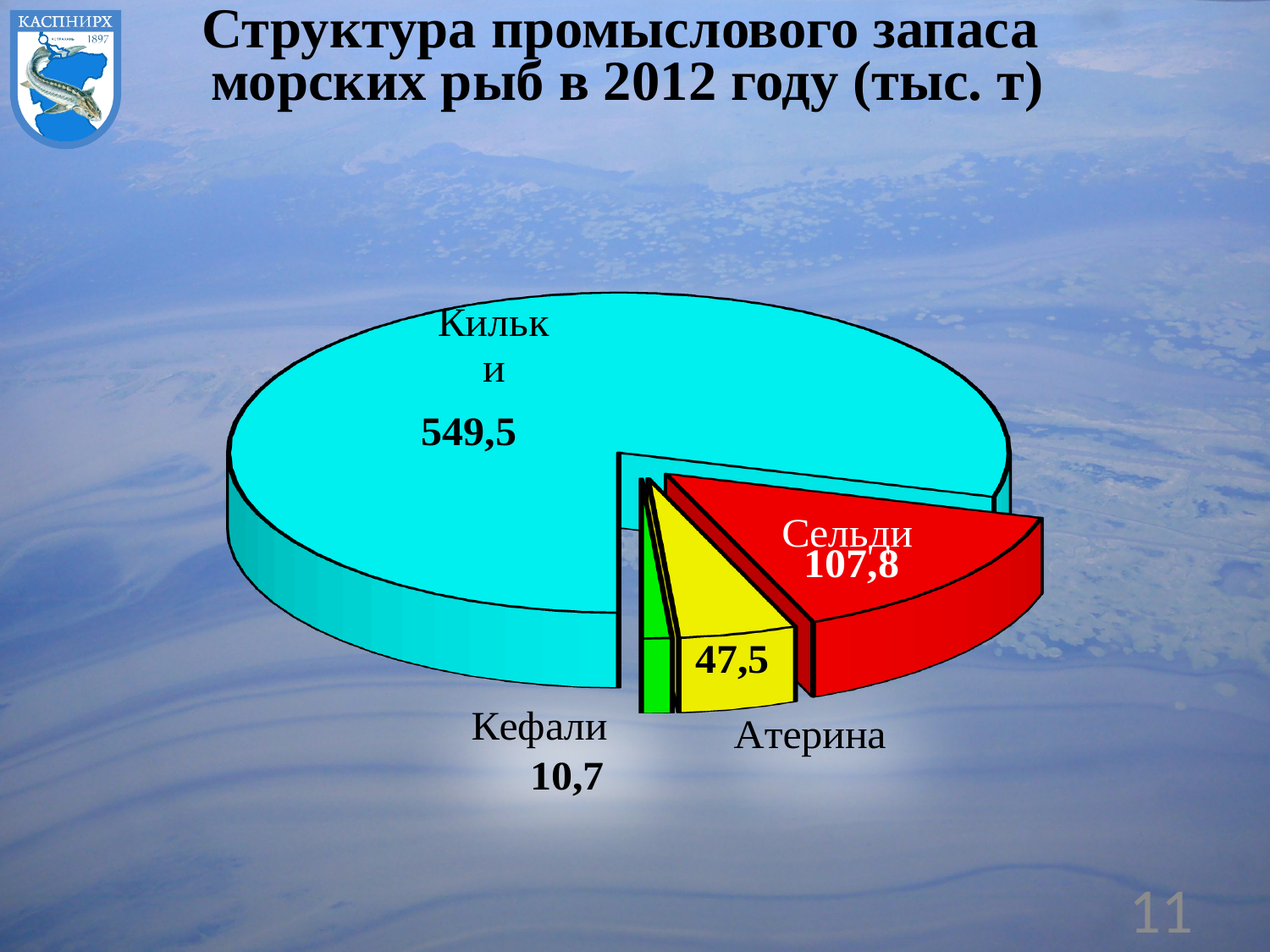
What is the difference between the values for Атерина and Кефали? 36,8 Which category has the largest slice of the pie? Кильки What type of chart is shown on the slide? Pie chart What is the value for Кильки? 549,5 Which category has the smallest slice of the pie? Кефали Which is larger, the value for Сельди or the value for Атерина? Сельди What is the difference between the values for Кильки and Сельди? 441,7 What is the value for Сельди? 107,8 What is the value for Атерина? 47,5 What is the value for Кефали? 10,7 How many categories (slices) does the pie chart have? 4 What is the title of the chart on the slide? Структура промыслового запаса морских рыб в 2012 году (тыс. т)